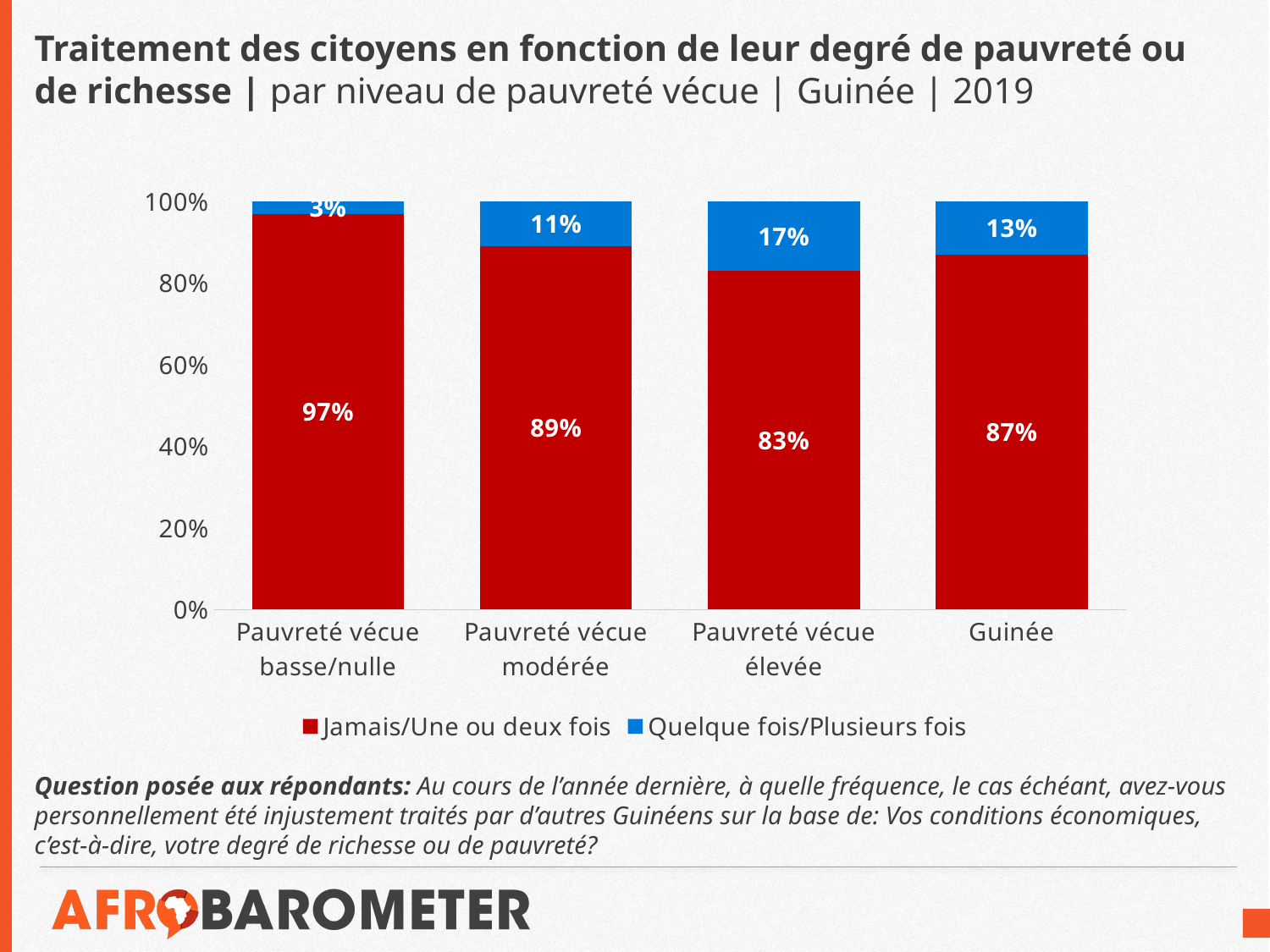
Which category has the highest value for "Quelque fois/Plusieurs fois"? Pauvreté vécue élevée What is the value of "Quelque fois/Plusieurs fois" for "Pauvreté vécue modérée"? 11% What is the value of "Quelque fois/Plusieurs fois" for "Pauvreté vécue élevée"? 17% What is the value of "Jamais/Une ou deux fois" for "Guinée"? 87% What kind of chart is shown on the slide? Stacked bar chart How many series does the legend list? 2 What is the difference between the "Jamais/Une ou deux fois" values for "Pauvreté vécue basse/nulle" and "Pauvreté vécue élevée"? 14 percentage points What is the total of the stacked bar for "Pauvreté vécue modérée"? 100% Which is larger: the "Quelque fois/Plusieurs fois" value for "Guinée" or for "Pauvreté vécue modérée"? Guinée What is the value of "Jamais/Une ou deux fois" for "Pauvreté vécue basse/nulle"? 97% Which category has the lowest value for "Jamais/Une ou deux fois"? Pauvreté vécue élevée How many categories are shown on the x axis? 4